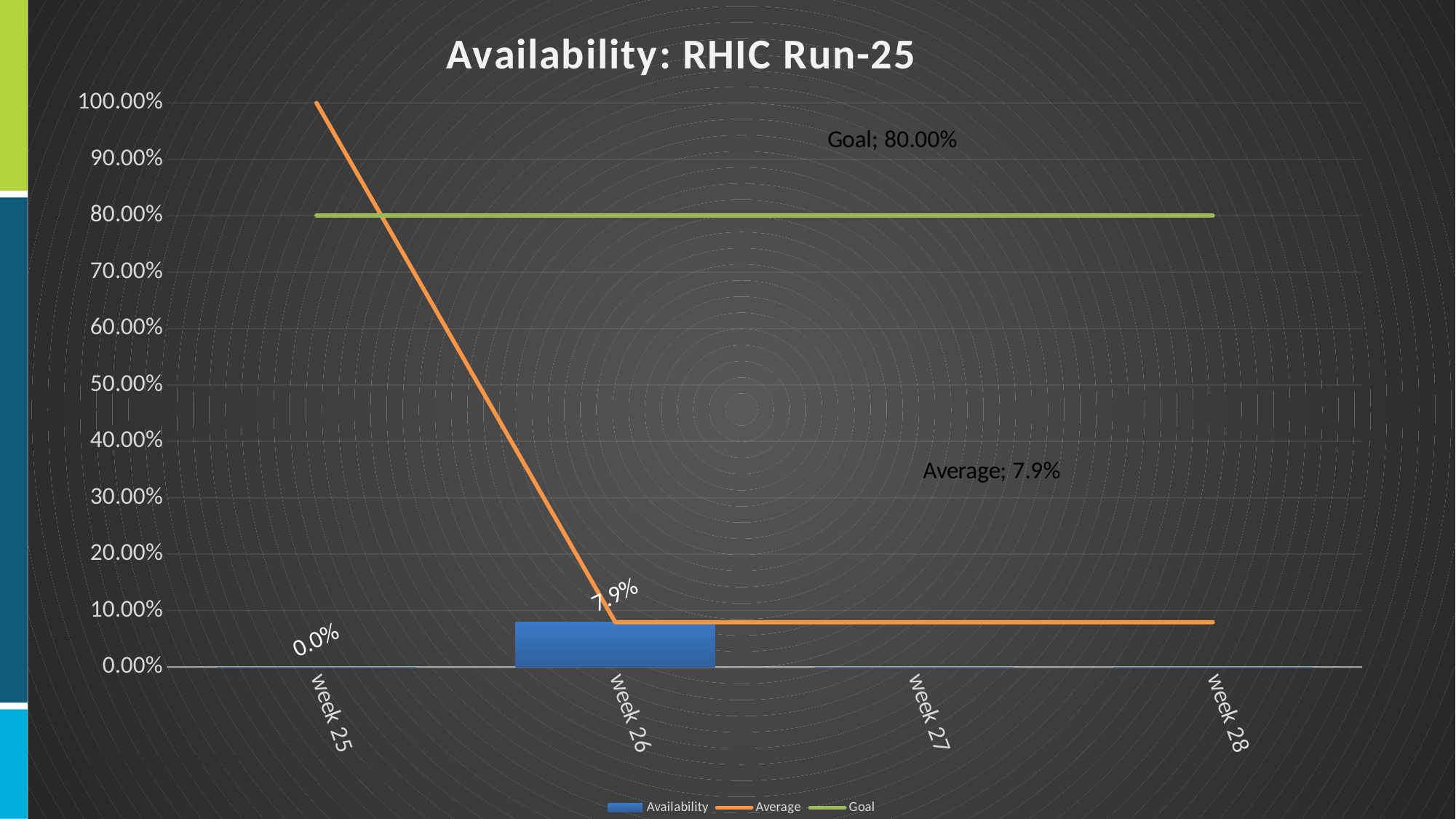
What is the difference between the Goal value and the Availability for week 26? 72.1% Does the Average line rise or fall from week 25 to week 26? fall What is the Availability value for week 25? 0.0% What value is the Average series labelled with? 7.9% What is the title of the chart? Availability: RHIC Run-25 Is the Goal line greater or less than 50.00%? greater Which is larger, the Availability for week 25 or for week 26? week 26 What is the Availability value for week 26? 7.9% What value is the Goal line labelled with? 80.00% Which week has the highest Availability bar? week 26 How many weeks are shown on the x axis? 4 How many series does the legend list? 3